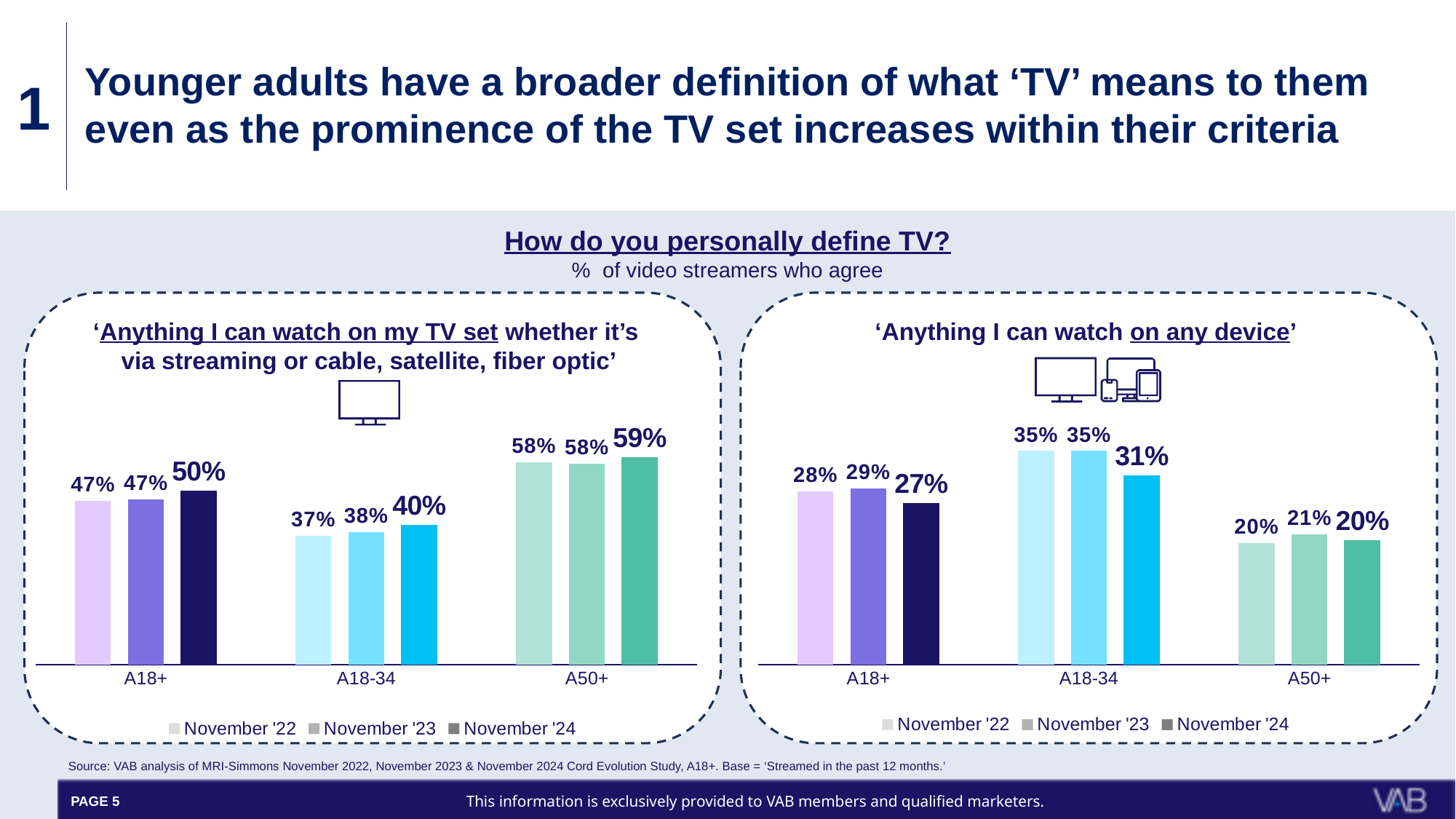
In the left chart ('Anything I can watch on my TV set'), do the values for A18-34 rise or fall from November '22 to November '24? rise In the right chart ('Anything I can watch on any device'), what is the November '23 value for A18+? 29% How many series does the legend of the right chart ('Anything I can watch on any device') list? 3 In the right chart ('Anything I can watch on any device'), which age group has the lowest November '22 value? A50+ In the left chart ('Anything I can watch on my TV set'), what is the November '24 value for A18-34? 40% In the left chart ('Anything I can watch on my TV set'), what is the difference between the November '24 values for A50+ and A18-34? 19% In the right chart ('Anything I can watch on any device'), is the November '24 value for A18+ larger or smaller than the November '24 value for A18-34? smaller In the right chart ('Anything I can watch on any device'), what is the difference between the November '22 and November '24 values for A18-34? 4% How many age groups are shown on the x axis of the left chart ('Anything I can watch on my TV set')? 3 What kind of chart is the left chart ('Anything I can watch on my TV set')? bar chart In the left chart ('Anything I can watch on my TV set'), which age group has the highest November '24 value? A50+ What is the question shown as the title above both charts? How do you personally define TV?